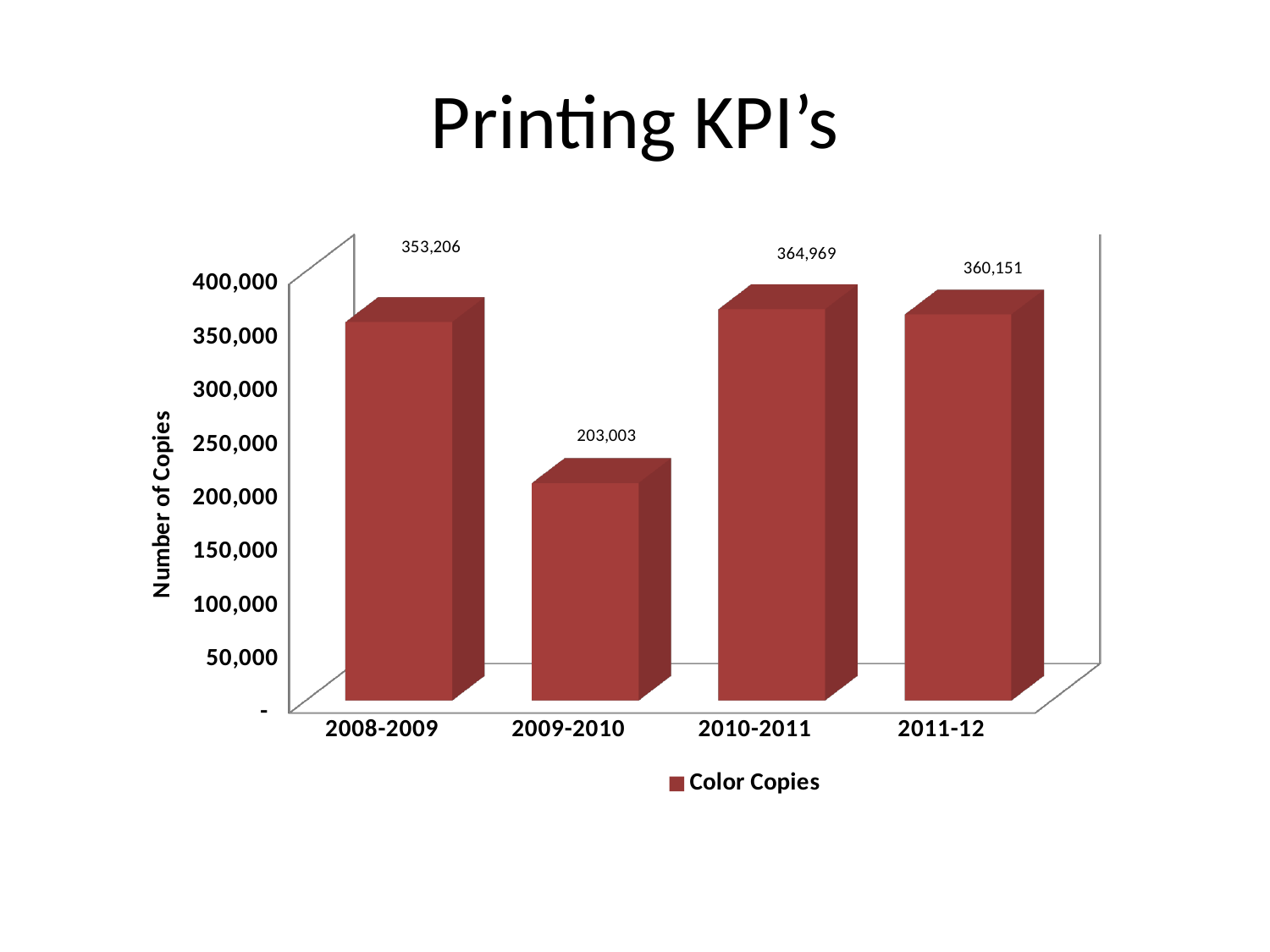
What is the number of color copies for 2008-2009? 353,206 Which year has more color copies, 2008-2009 or 2009-2010? 2008-2009 What is the number of color copies for 2010-2011? 364,969 What is the label of the vertical axis? Number of Copies How many series does the legend list? 1 What is the number of color copies for 2009-2010? 203,003 What kind of chart is shown on the slide? Bar chart What is the difference in color copies between 2010-2011 and 2009-2010? 161,966 Which year has the lowest number of color copies? 2009-2010 What is the number of color copies for 2011-12? 360,151 Which year has the highest number of color copies? 2010-2011 How many years are shown on the chart? 4